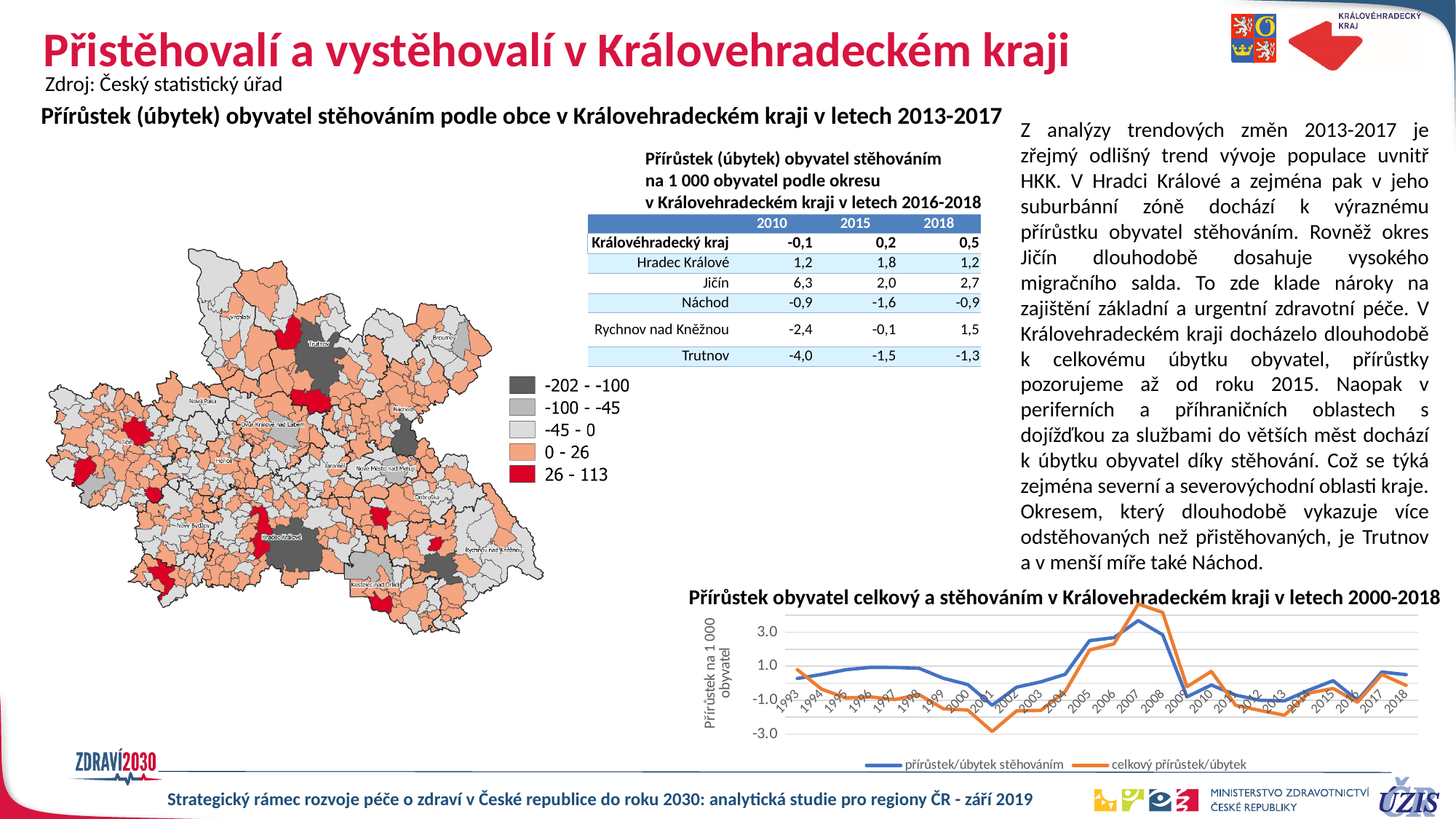
In the line chart at the bottom right, which year has the lowest value for 'celkový přírůstek/úbytek'? 2001 In the line chart at the bottom right, which series has the higher value in 2007, 'přírůstek/úbytek stěhováním' or 'celkový přírůstek/úbytek'? celkový přírůstek/úbytek What kind of chart is 'Přírůstek obyvatel celkový a stěhováním v Královehradeckém kraji v letech 2000-2018'? line chart In the line chart at the bottom right, is the value for 'přírůstek/úbytek stěhováním' in 2007 greater or less than 3.0? greater How many series does the legend of the line chart 'Přírůstek obyvatel celkový a stěhováním v Královehradeckém kraji v letech 2000-2018' list? 2 In the line chart at the bottom right, do the values of 'přírůstek/úbytek stěhováním' rise or fall from 2007 to 2009? fall In the line chart at the bottom right, how many years are plotted along the x axis? 26 In the map legend on the left, what is the range shown in red? 26 - 113 What is the y-axis label of the line chart at the bottom right? Přírůstek na 1 000 obyvatel In the line chart at the bottom right, is the value for 'přírůstek/úbytek stěhováním' in 2005 greater or less than 1.0? greater In the line chart at the bottom right, which year has the highest value for 'přírůstek/úbytek stěhováním'? 2007 In the line chart at the bottom right, is the value for 'celkový přírůstek/úbytek' in 2001 greater or less than -1.0? less